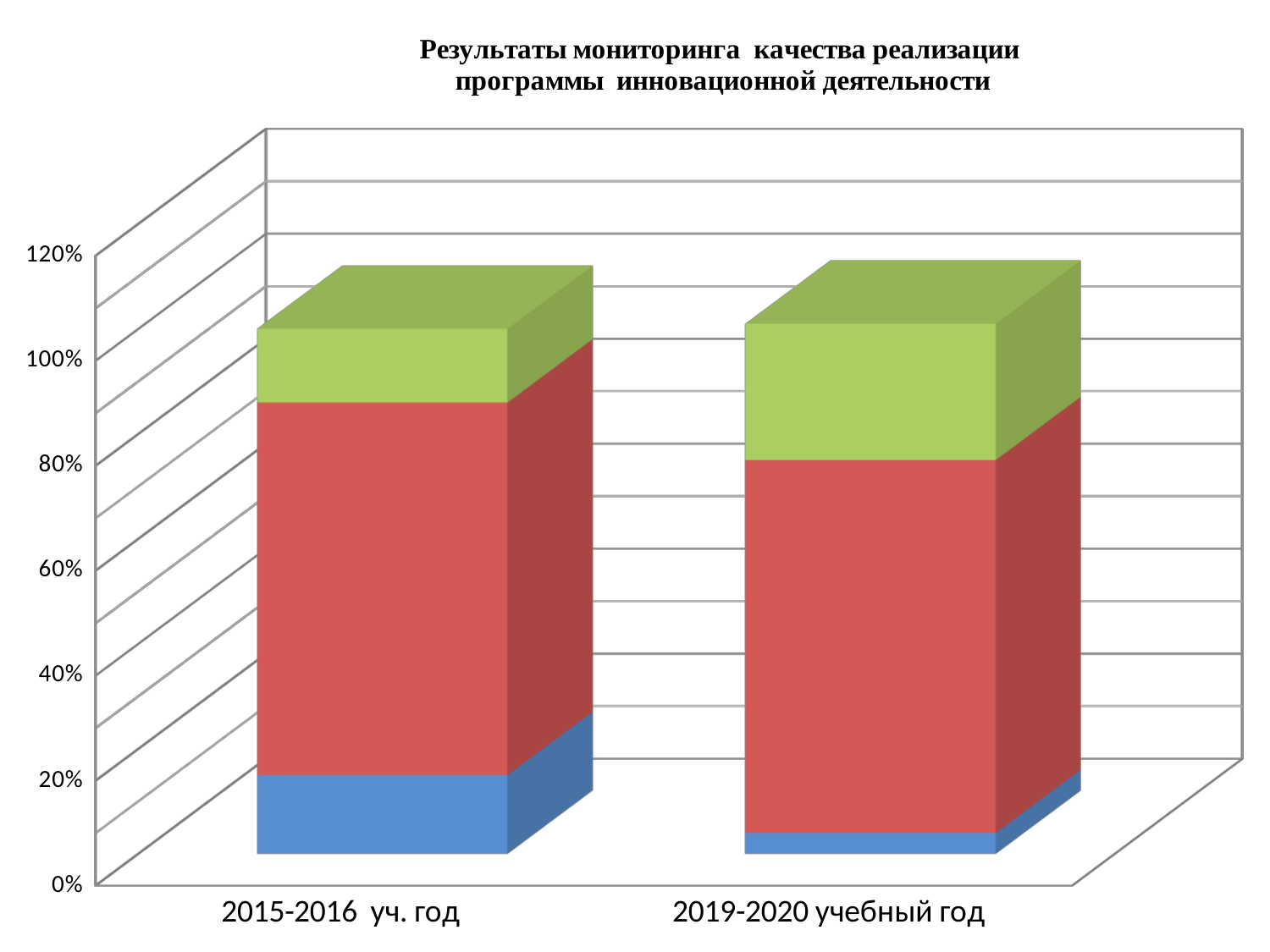
What is the title of the chart? Результаты мониторинга качества реализации программы инновационной деятельности What kind of chart is shown on the slide? stacked bar chart Is the total height of the 2015-2016 уч. год bar greater or less than 80%? greater Which category is labelled on the left of the x axis? 2015-2016 уч. год Is the top of the red segment for 2019-2020 учебный год greater or less than 60%? greater How many categories (academic years) are shown on the x axis? 2 Which category has the larger green segment, 2015-2016 уч. год or 2019-2020 учебный год? 2019-2020 учебный год Is the blue segment for 2019-2020 учебный год greater or less than 20%? less How many coloured segments make up each stacked bar? 3 Which category has the larger blue segment, 2015-2016 уч. год or 2019-2020 учебный год? 2015-2016 уч. год What is the highest value labelled on the vertical axis? 120%